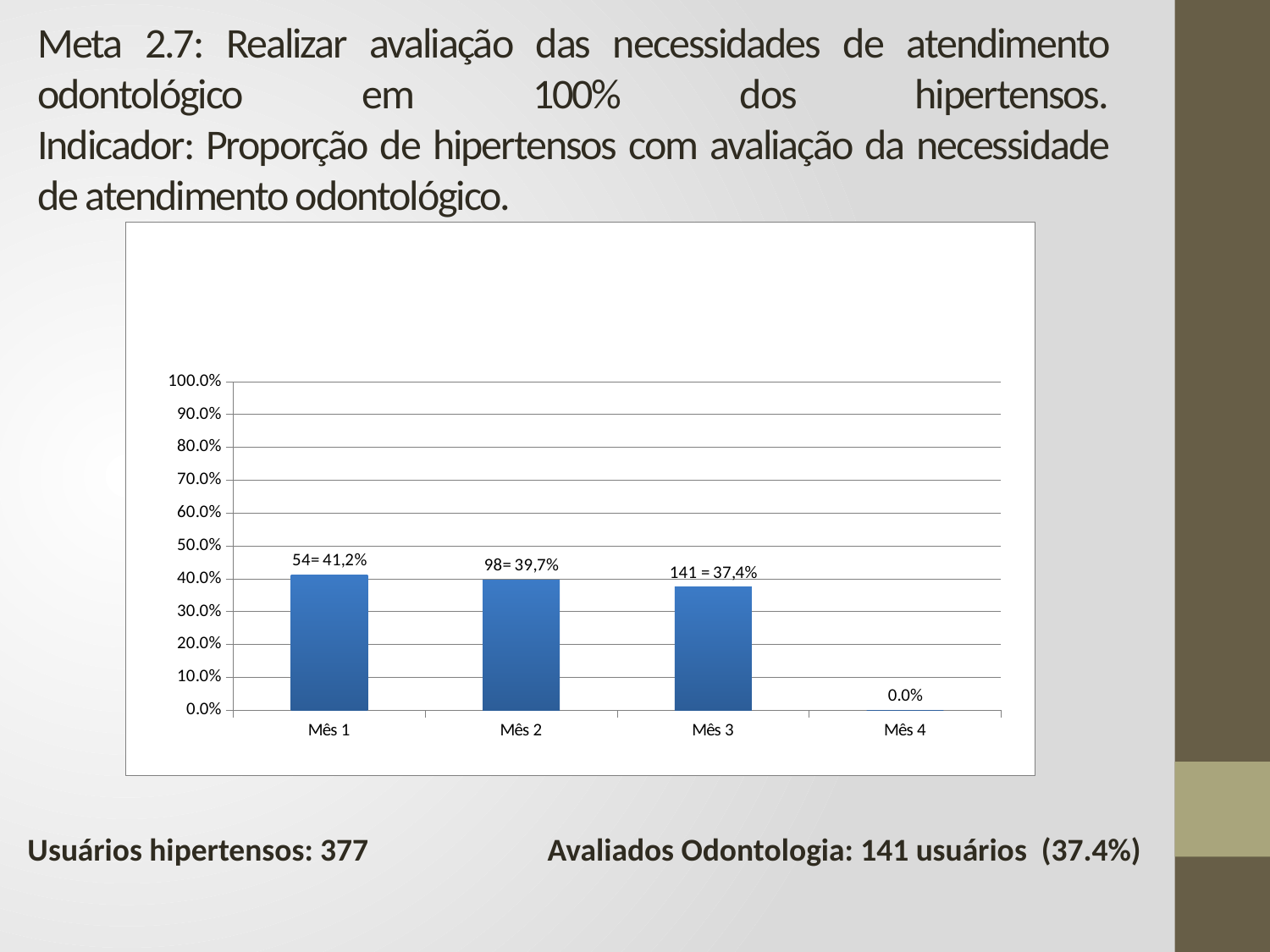
What is the value shown for Mês 4? 0.0% What is the data label shown for Mês 3? 141 = 37,4% Do the percentages rise or fall from Mês 1 to Mês 3? fall Which month has the highest percentage in the chart? Mês 1 How many categories are shown on the x axis of the chart? 4 What is the highest value shown on the y axis of the chart? 100.0% What is the data label shown for Mês 1? 54= 41,2% What kind of chart is shown on the slide? bar chart What is the data label shown for Mês 2? 98= 39,7% Which month has the lowest percentage in the chart? Mês 4 Is the value for Mês 2 greater or less than 50.0%? less Which is larger, the percentage for Mês 1 or for Mês 3? Mês 1